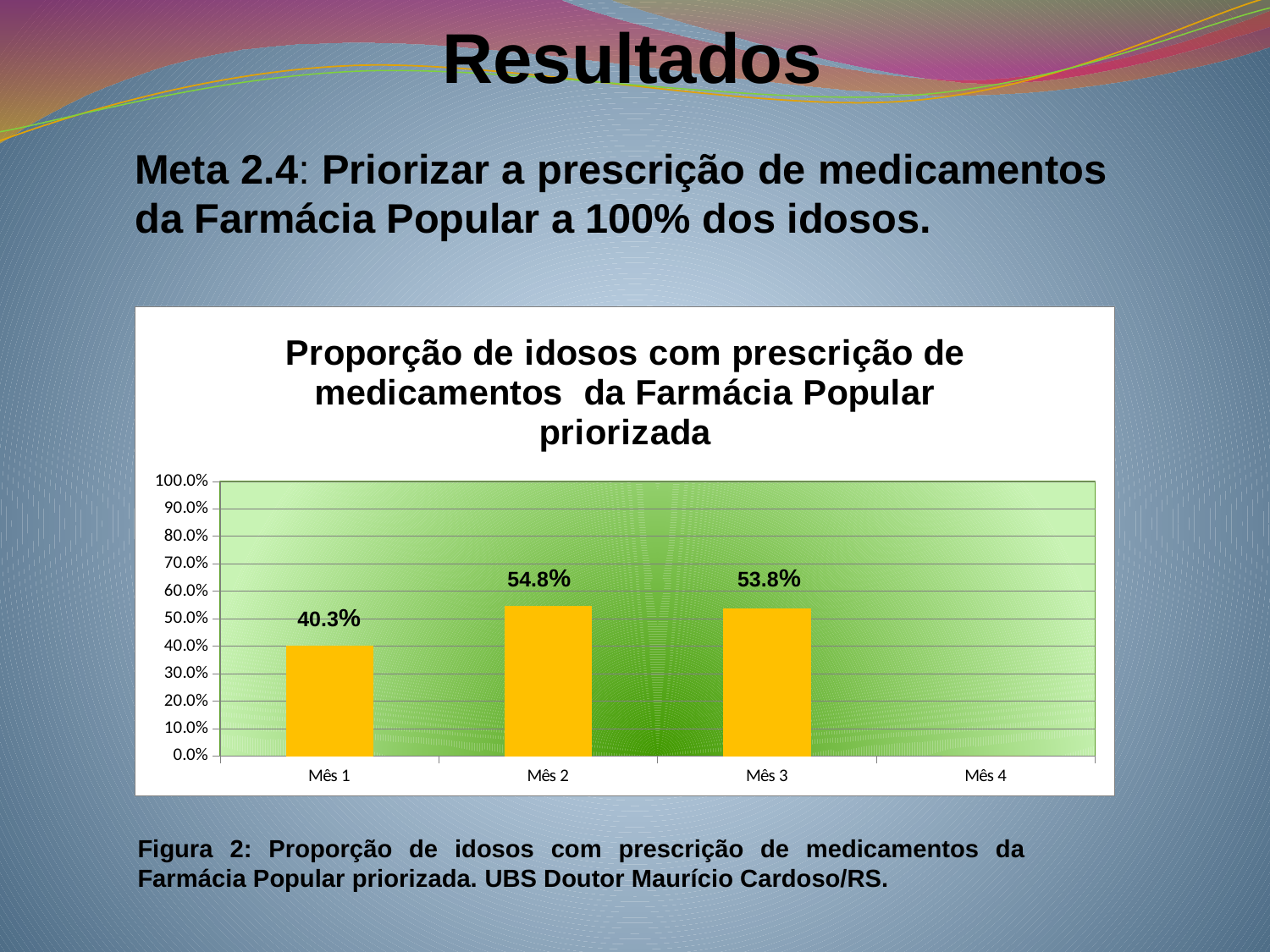
Among the months with a bar shown, which has the lowest value? Mês 1 What is the value for Mês 1? 40.3% Which is larger, the value for Mês 2 or the value for Mês 3? Mês 2 Does the value rise or fall from Mês 1 to Mês 2? Rise How many month categories are shown on the x axis? 4 Is the value for Mês 1 greater or less than 50.0%? less What is the title of the chart? Proporção de idosos com prescrição de medicamentos da Farmácia Popular priorizada What is the value for Mês 3? 53.8% What kind of chart is shown? Bar chart What is the value for Mês 2? 54.8% Which month has the highest value? Mês 2 What is the difference between the values for Mês 2 and Mês 1? 14.5 percentage points